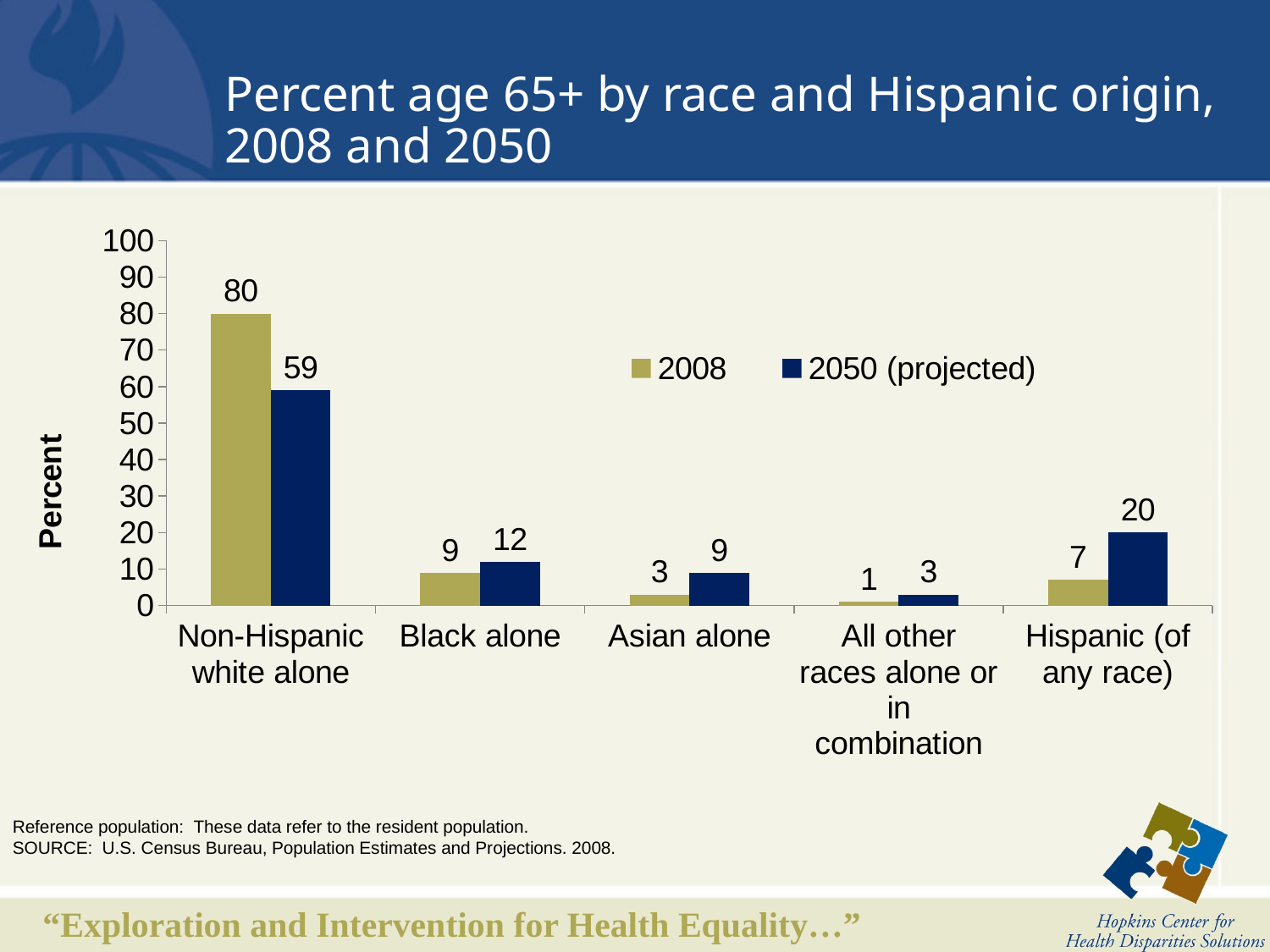
What is the 2008 value for Non-Hispanic white alone? 80 How many series does the legend list? 2 Which is larger for Black alone: the 2008 value or the 2050 (projected) value? 2050 (projected) Which category has the highest 2050 (projected) value? Non-Hispanic white alone What is the label of the y axis? Percent What is the difference between the 2008 and 2050 (projected) values for Non-Hispanic white alone? 21 What is the 2008 value for Asian alone? 3 Which category has the lowest 2008 value? All other races alone or in combination What is the 2050 (projected) value for Hispanic (of any race)? 20 Is the 2050 (projected) value for Non-Hispanic white alone greater or less than 50? greater What kind of chart is shown on the slide? bar chart How many categories are shown on the x axis? 5